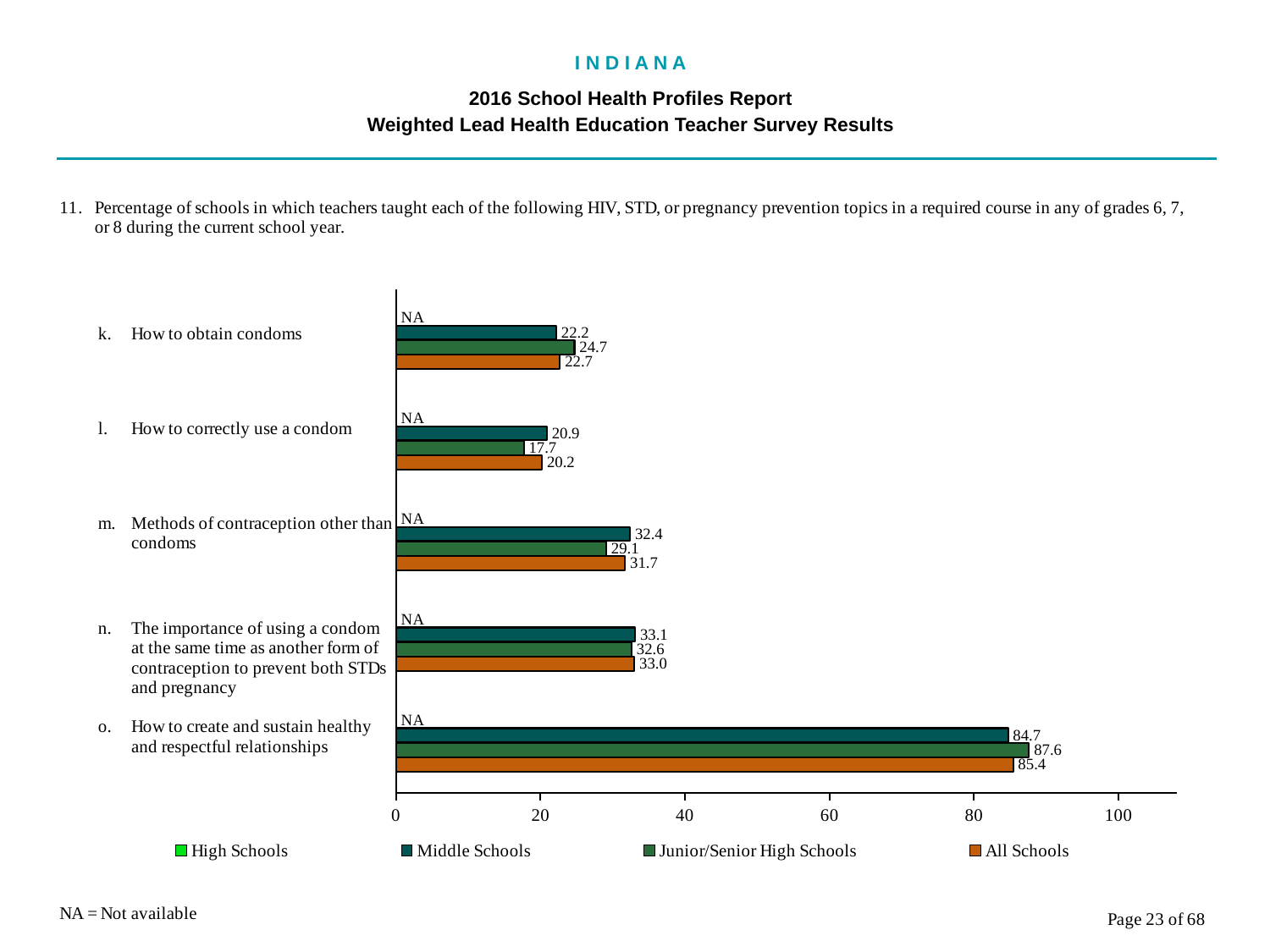
What is the value for Junior/Senior High Schools for 'How to correctly use a condom'? 17.7 Which topic has the lowest value for Junior/Senior High Schools? How to correctly use a condom What kind of chart is shown on the slide? Bar chart How many topics are listed on the chart? 5 What is the difference between the Junior/Senior High Schools and Middle Schools values for 'How to create and sustain healthy and respectful relationships'? 2.9 Which topic has the highest value for All Schools? How to create and sustain healthy and respectful relationships For 'Methods of contraception other than condoms', which is larger: the Middle Schools value or the Junior/Senior High Schools value? Middle Schools What is the value for Junior/Senior High Schools for 'How to create and sustain healthy and respectful relationships'? 87.6 What is the value for All Schools for 'Methods of contraception other than condoms'? 31.7 What value is shown for High Schools for every topic on the chart? NA How many series does the legend list? 4 What is the value for Middle Schools for 'How to obtain condoms'? 22.2